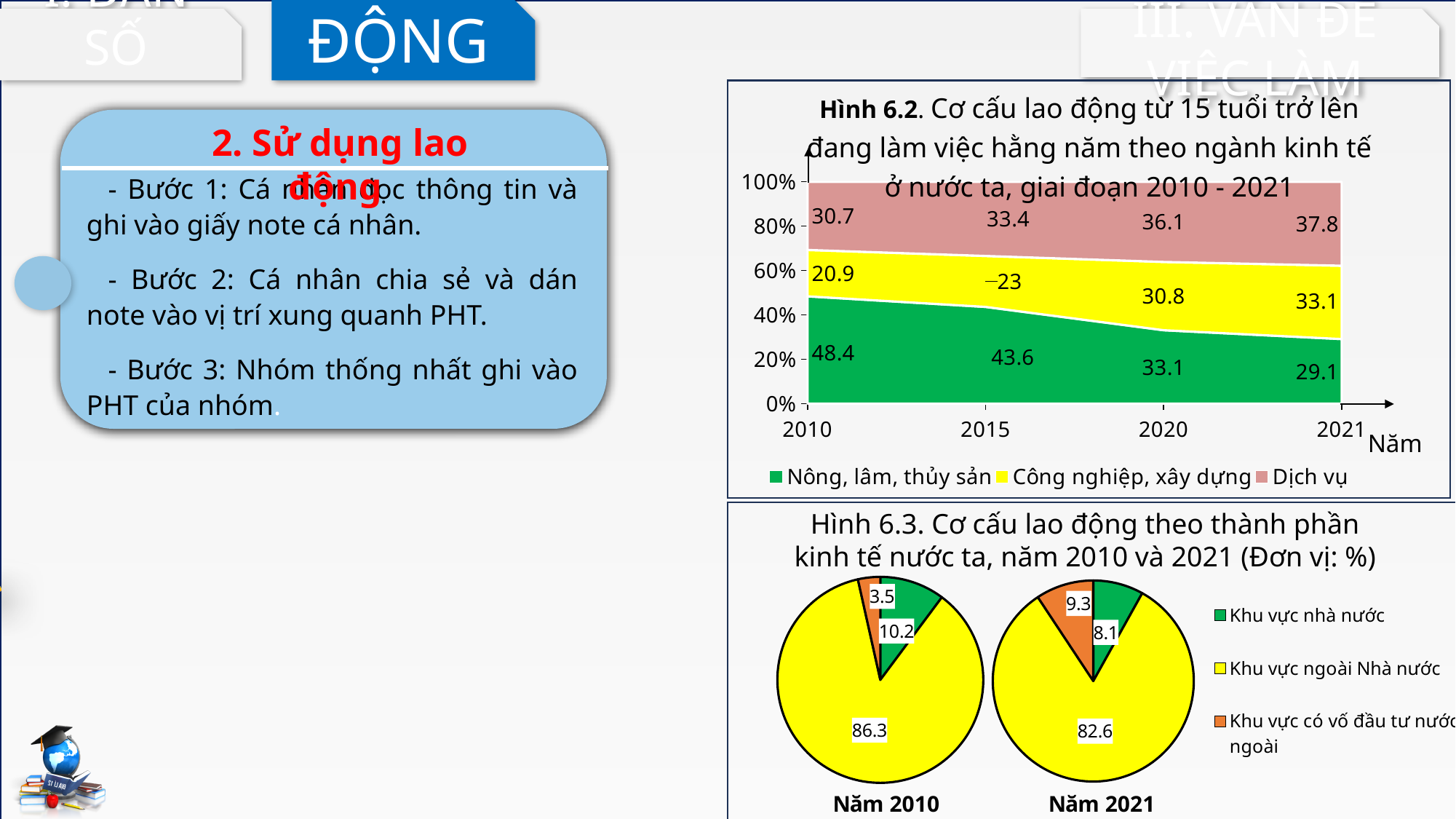
In Hình 6.3, what is the share of Khu vực ngoài Nhà nước in Năm 2010? 86.3 In Hình 6.2, what is the value for Công nghiệp, xây dựng in 2015? 23 In Hình 6.3, what is the value for Khu vực có vốn đầu tư nước ngoài in Năm 2021? 9.3 In Hình 6.2, how many years are shown on the x axis? 4 In Hình 6.2, does the share of Nông, lâm, thủy sản rise or fall from 2010 to 2021? fall In Hình 6.2, how many series does the legend list? 3 In Hình 6.2, what is the difference between the Nông, lâm, thủy sản values in 2010 and 2021? 19.3 What kind of chart is Hình 6.3? pie chart In Hình 6.2, in which year is the value for Dịch vụ highest? 2021 In Hình 6.2, what is the value for Dịch vụ in 2021? 37.8 In Hình 6.2, what is the value for Nông, lâm, thủy sản in 2010? 48.4 In Hình 6.3, which is larger: Khu vực nhà nước in Năm 2010 or in Năm 2021? Năm 2010